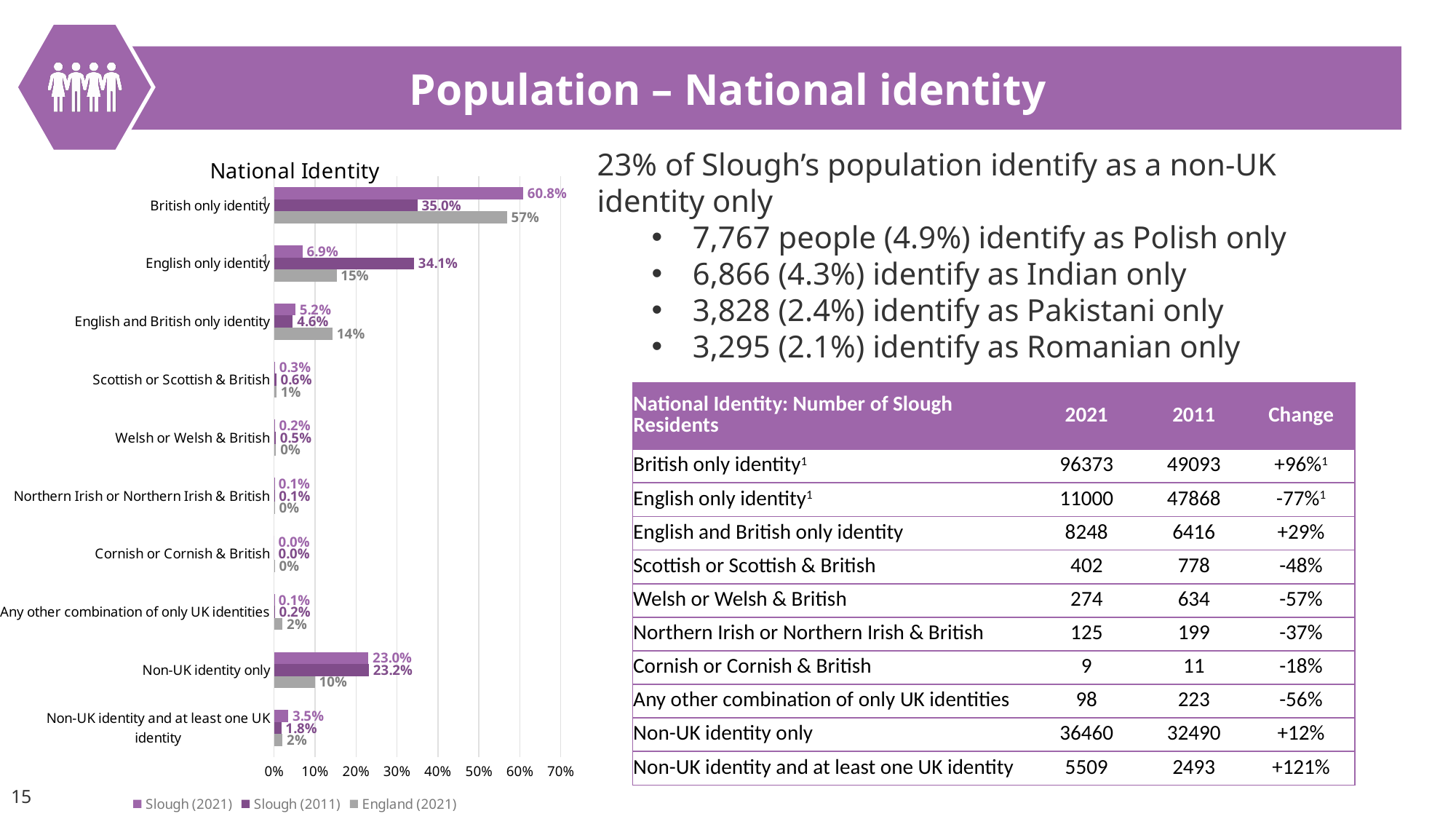
Is the England (2021) value for British only identity greater or less than 50%? greater What is the Slough (2021) value for Non-UK identity and at least one UK identity? 3.5% What is the difference between the Slough (2021) and Slough (2011) values for British only identity? 25.8% What is the Slough (2011) value for English only identity? 34.1% Which is larger for English only identity: the Slough (2021) value or the Slough (2011) value? Slough (2011) Which category has the highest Slough (2021) value? British only identity How many series does the legend list? 3 How many categories are shown on the chart? 10 Which category has the lowest England (2021) value among those with a non-zero label? Scottish or Scottish & British What kind of chart is shown on the slide? Bar chart What is the Slough (2021) value for British only identity? 60.8% What is the England (2021) value for Non-UK identity only? 10%